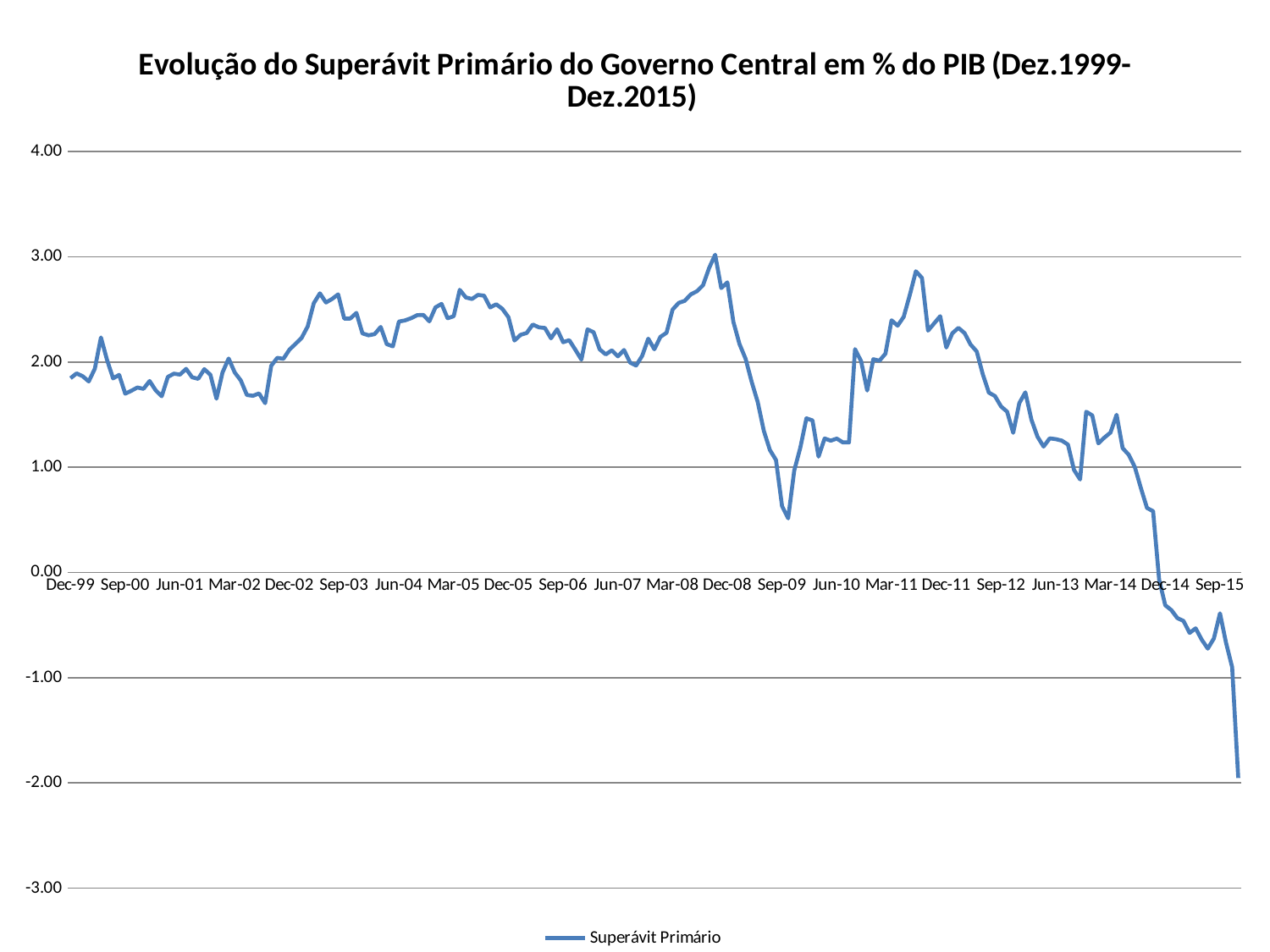
Is the value at Sep-15 greater or less than 0.00? less Does the line rise or fall between Dec-11 and the end of the series? fall Is the value at Sep-09 greater or less than 1.00? less Is the value at Sep-12 greater or less than 2.00? less What is the name of the series shown in the legend? Superávit Primário How many series does the legend list? 1 What kind of chart is shown on the slide? line chart Around which x-axis label does the line reach its highest value? Dec-08 What is the title of the chart? Evolução do Superávit Primário do Governo Central em % do PIB (Dez.1999-Dez.2015) Which is larger, the value at Dec-08 or the value at Sep-09? Dec-08